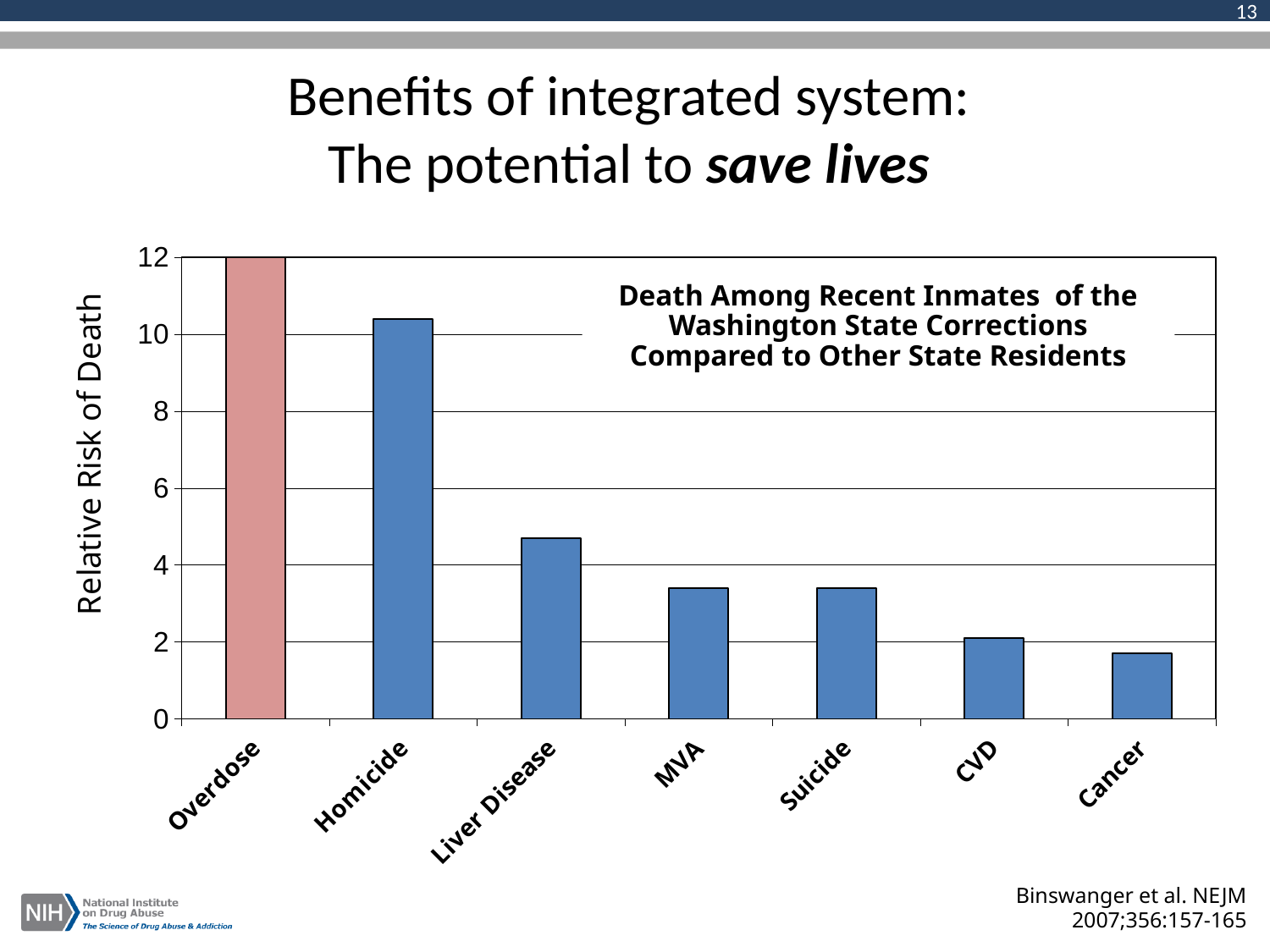
What is the relative risk of death for Overdose in the chart? 12 Which cause of death has the lowest relative risk in the chart? Cancer Is the relative risk of death for Liver Disease greater or less than 4? greater What is the label on the y axis of the chart? Relative Risk of Death Do the bar values generally rise or fall from left to right along the x axis? fall Is the relative risk of death for Homicide greater or less than 10? greater Which has a higher relative risk of death, Homicide or Liver Disease? Homicide How many causes of death are shown on the x axis of the chart? 7 What type of chart is shown on the slide? bar chart Is the relative risk of death for Cancer greater or less than 2? less Which cause of death has the highest relative risk in the chart? Overdose